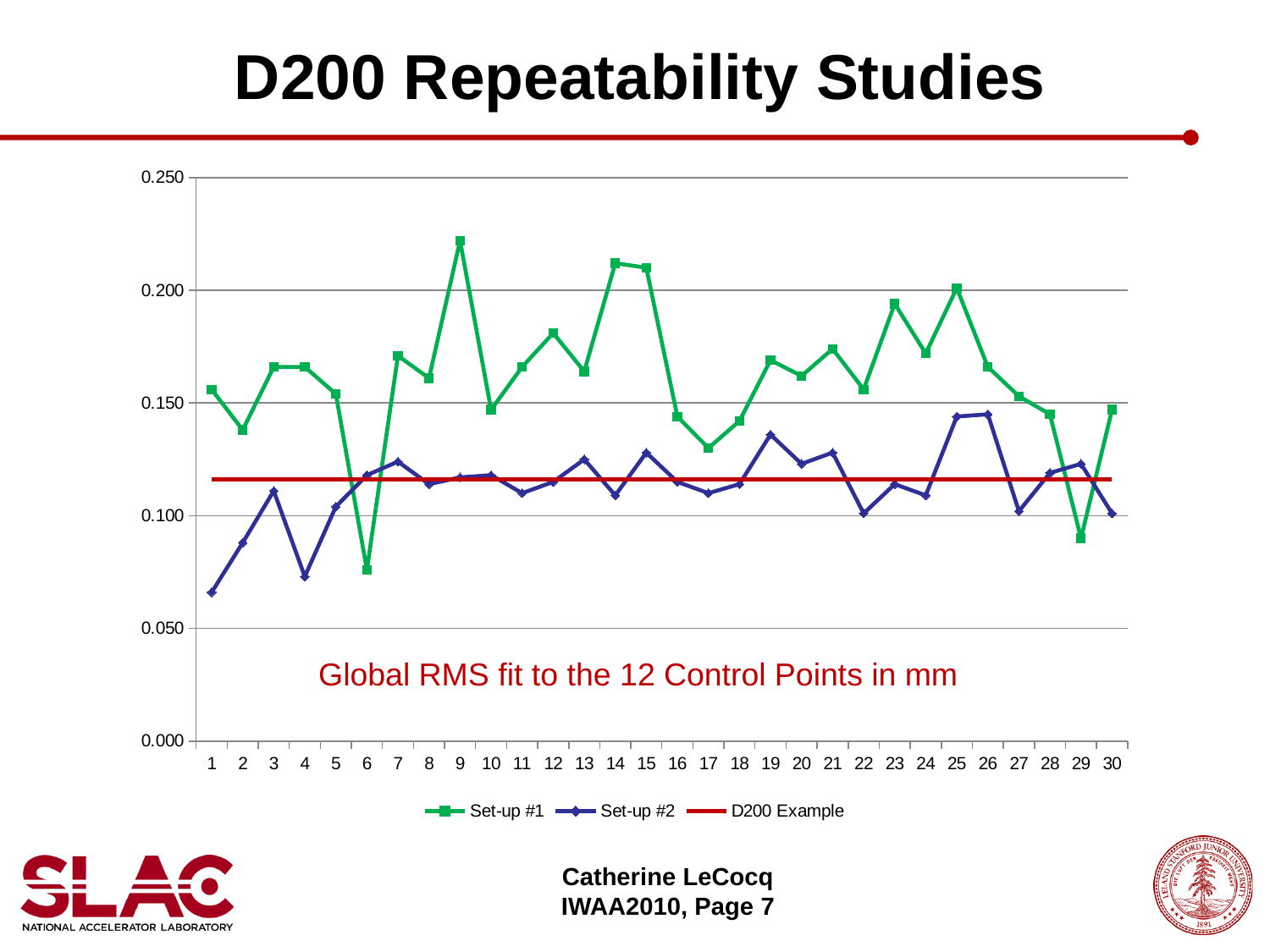
Is the value for Set-up #1 at point 6 greater or less than 0.100? less At point 9, which series has the larger value, Set-up #1 or Set-up #2? Set-up #1 Is the value for Set-up #2 at point 1 greater or less than 0.100? less Is the value for Set-up #1 at point 9 greater or less than 0.200? greater At which x-axis point does Set-up #1 reach its lowest value? 6 How many points are plotted along the x axis for each set-up series? 30 At point 6, which series has the larger value, Set-up #1 or Set-up #2? Set-up #2 What kind of chart is shown on the slide? line chart How many series does the legend list? 3 At which x-axis point does Set-up #1 reach its highest value? 9 What is the name of the series drawn as the flat red line? D200 Example